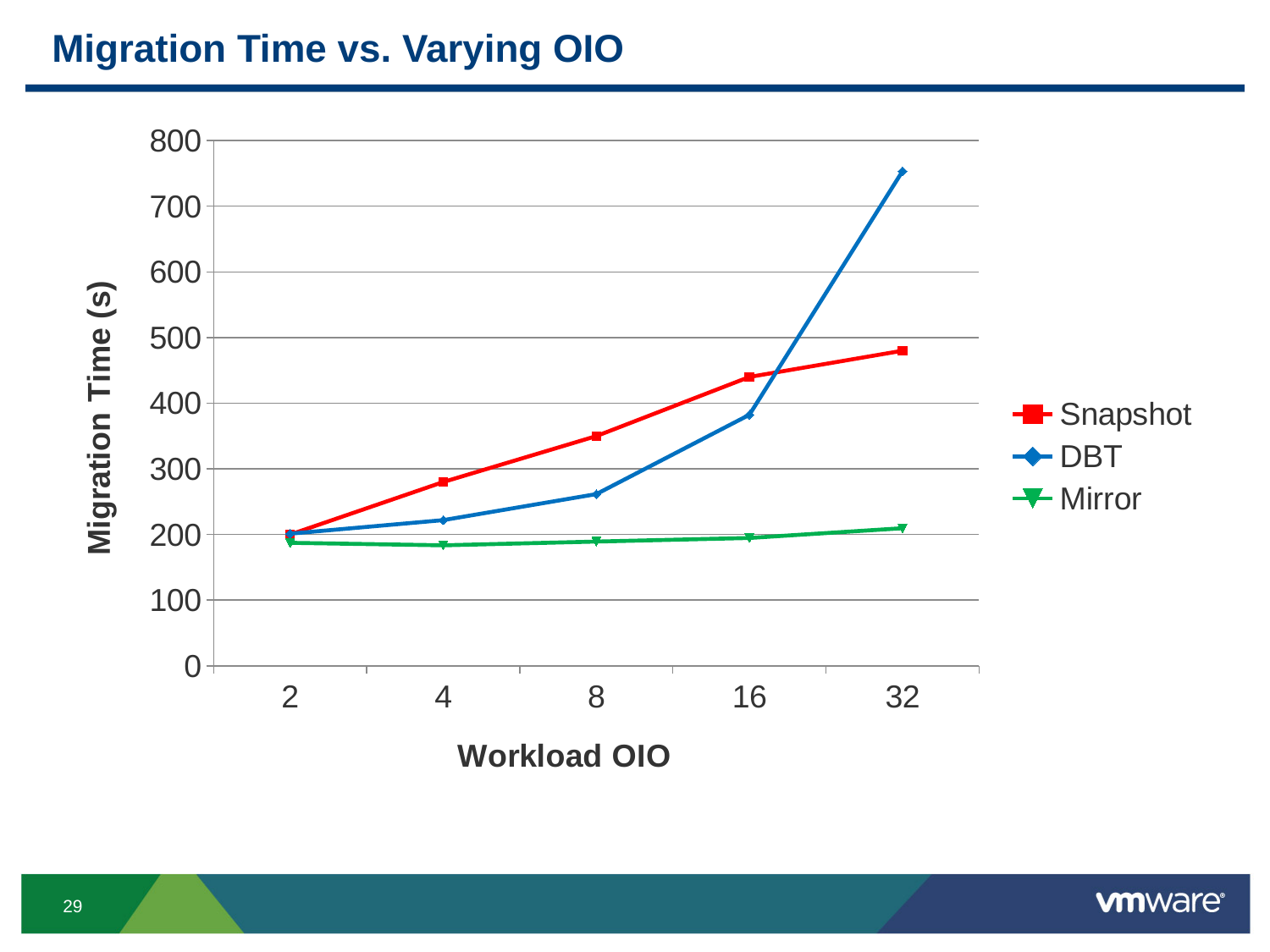
Is the DBT value at Workload OIO 32 greater or less than 700? greater Is the Snapshot value at Workload OIO 16 greater or less than 400? greater What kind of chart is shown on the slide? line chart How many series does the legend list? 3 What is the title of the y axis? Migration Time (s) Which series has the highest migration time at Workload OIO 32? DBT Is the DBT value at Workload OIO 8 greater or less than 300? less How many Workload OIO values are plotted along the x axis? 5 Does the Snapshot migration time rise or fall as Workload OIO increases from 2 to 32? rise Which series has the lowest migration time at Workload OIO 32? Mirror At Workload OIO 16, which series has the larger migration time, Snapshot or DBT? Snapshot